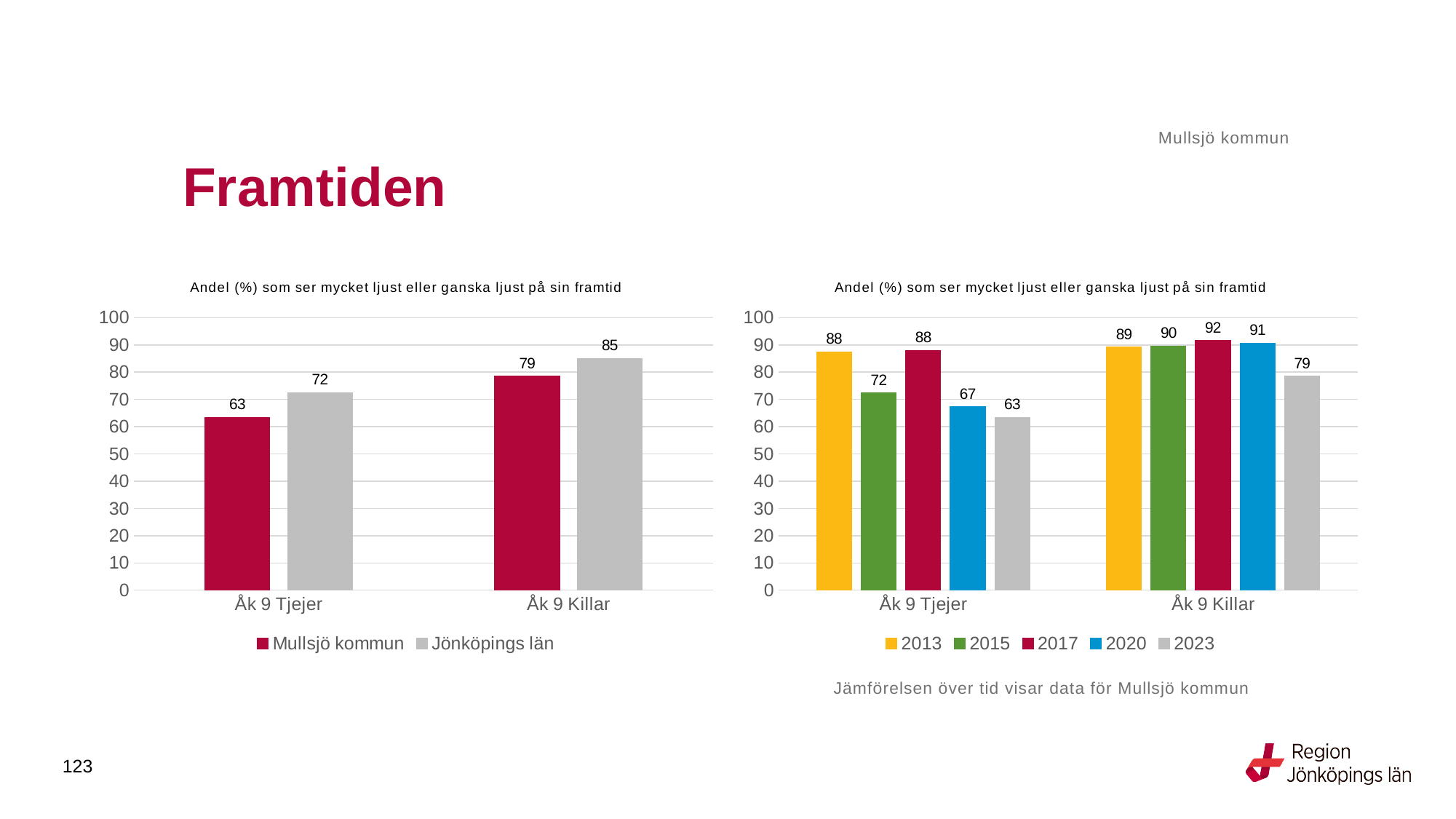
In the right chart, which year has the highest value for Åk 9 Killar? 2017 In the right chart, which year has the lowest value for Åk 9 Tjejer? 2023 In the left chart, what is the value for Mullsjö kommun for Åk 9 Tjejer? 63 What kind of chart is the left chart? Bar chart In the right chart, what is the difference between the 2013 and 2023 values for Åk 9 Tjejer? 25 In the right chart, what is the value for 2023 for Åk 9 Killar? 79 How many series does the legend of the left chart list? 2 In the left chart, what is the difference between Jönköpings län and Mullsjö kommun for Åk 9 Tjejer? 9 In the right chart, what is the value for 2020 for Åk 9 Tjejer? 67 In the left chart, which is larger for Åk 9 Killar: Mullsjö kommun or Jönköpings län? Jönköpings län In the left chart, what is the value for Jönköpings län for Åk 9 Killar? 85 How many series does the legend of the right chart list? 5